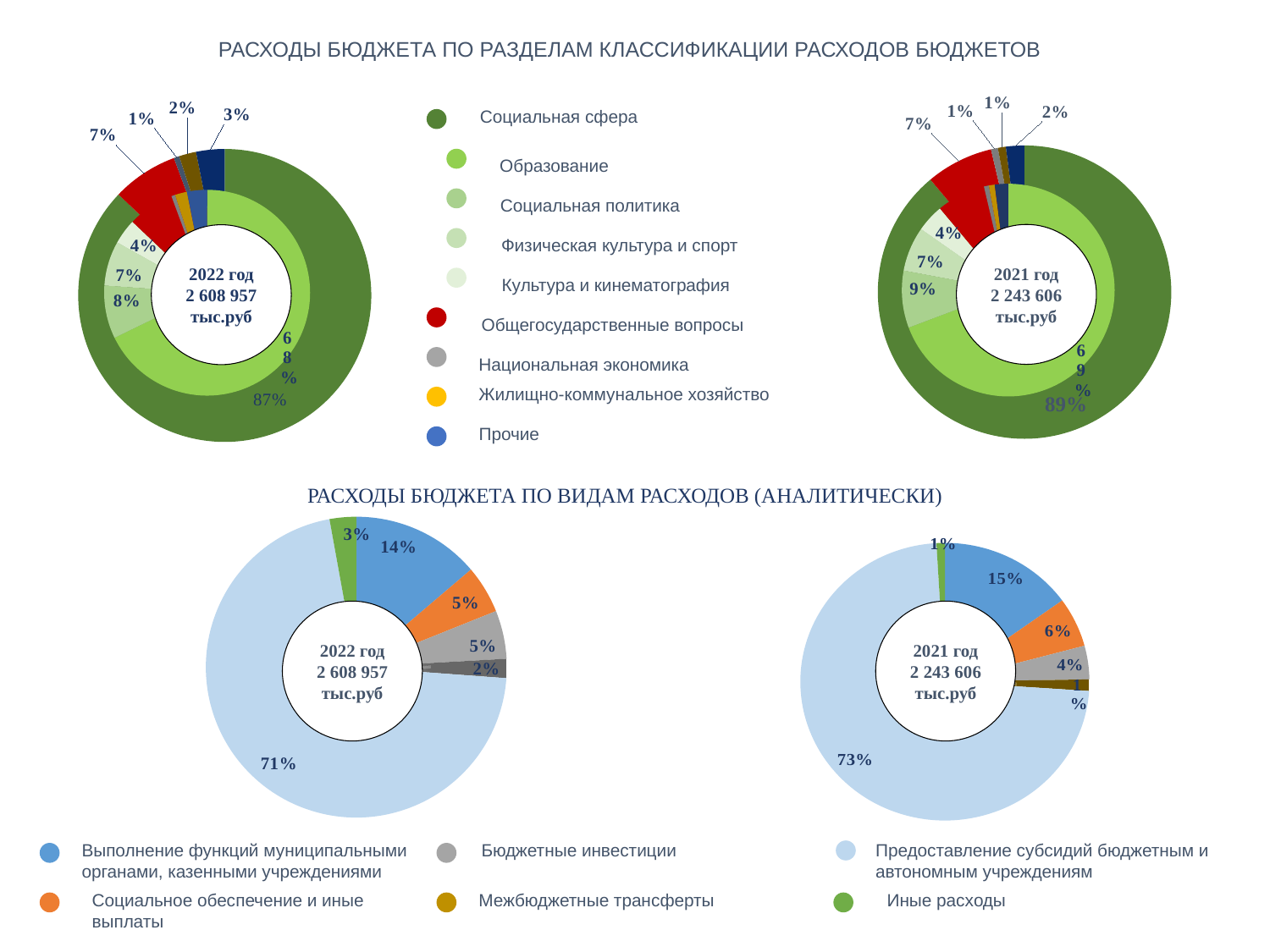
In the bottom-left donut chart (2022 год), which category has the largest share? Предоставление субсидий бюджетным и автономным учреждениям In the top-right donut chart (2021 год, расходы по разделам), what share is shown for Социальная сфера? 89% What total amount is printed in the centre of the 2022 год donut charts? 2 608 957 тыс.руб What is the difference between the share for Предоставление субсидий бюджетным и автономным учреждениям in the 2021 год chart (73%) and in the 2022 год chart (71%) in the bottom row? 2% In the bottom-right donut chart (2021 год, расходы по видам расходов), what share is shown for Выполнение функций муниципальными органами, казенными учреждениями? 15% What type of chart is used for the 2022 год расходы по видам расходов chart? Donut (pie) chart In the bottom-right donut chart (2021 год), which is larger: the share for Социальное обеспечение и иные выплаты or the share for Бюджетные инвестиции? Социальное обеспечение и иные выплаты How many entries does the legend of the bottom charts (расходы по видам расходов) list? 6 In the top-left donut chart (2022 год), what share is shown for Общегосударственные вопросы? 7% In the top-left donut chart (2022 год, расходы по разделам), what share is shown for Социальная сфера? 87% What total amount is printed in the centre of the 2021 год donut charts? 2 243 606 тыс.руб In the bottom-left donut chart (2022 год, расходы по видам расходов), what share is shown for Предоставление субсидий бюджетным и автономным учреждениям? 71%